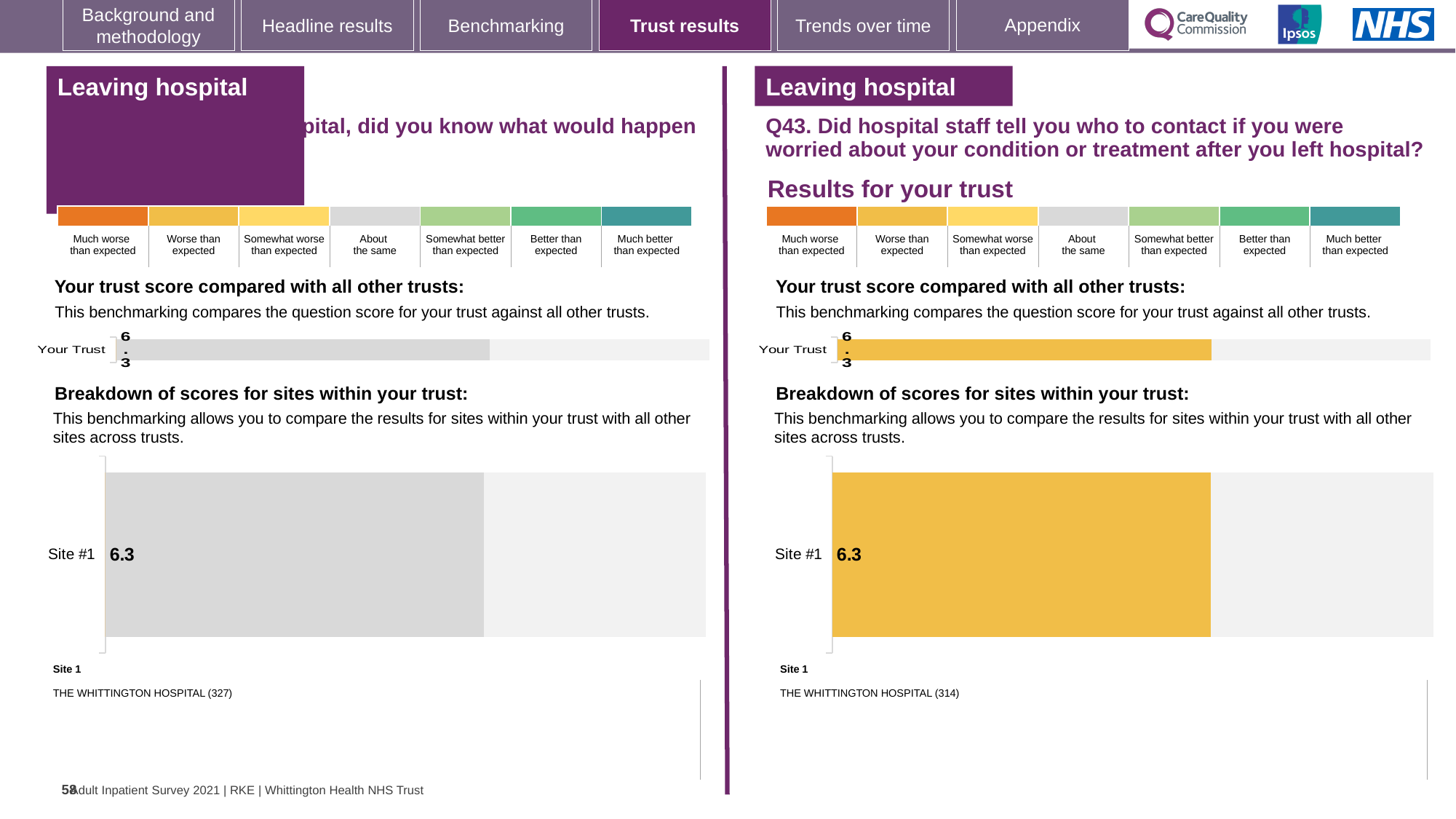
Is the Site #1 score on the right-hand side (Q43) greater or less than 5? greater Is the Site #1 score on the left-hand side greater or less than 7? less How many sites are shown in the breakdown of scores chart on the right-hand side (Q43)? 1 On the left-hand side, what is the score shown for Site #1 in the breakdown of scores for sites within your trust? 6.3 Which site is listed as Site 1 on the left-hand side? THE WHITTINGTON HOSPITAL (327) Which site is listed as Site 1 on the right-hand side (Q43)? THE WHITTINGTON HOSPITAL (314) How many sites are shown in the breakdown of scores chart on the left-hand side? 1 On the left-hand side, what is the score shown for Your Trust in the trust score comparison chart? 6.3 What type of chart is used to show the breakdown of scores for sites within your trust on the right-hand side (Q43)? bar chart On the right-hand side (Q43), what is the score shown for Your Trust in the trust score comparison chart? 6.3 On the right-hand side (Q43), what is the score shown for Site #1 in the breakdown of scores for sites within your trust? 6.3